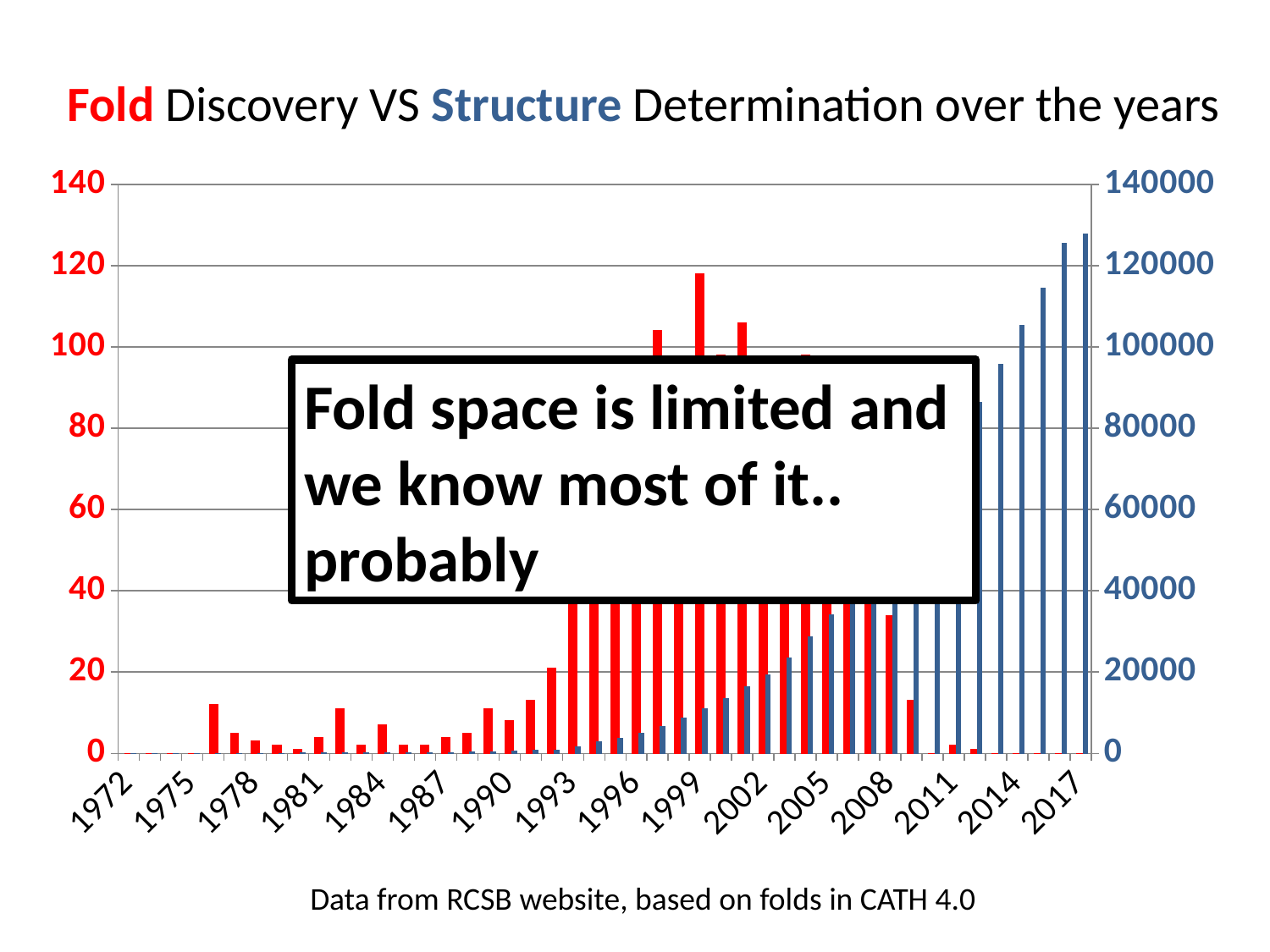
Is the red Fold value for 1991 greater or less than 20? less In which year is the blue Structure bar highest? 2017 What kind of chart is shown on the slide? bar chart Is the blue Structure value for 2014 greater or less than 80000? greater Is the blue Structure value for 2017 greater or less than 120000? greater What is the title of the chart? Fold Discovery VS Structure Determination over the years Do the blue Structure bars generally rise or fall from 1972 to 2017? rise Which year has the larger red Fold bar, 1999 or 2008? 1999 In which year is the red Fold bar highest? 1999 Which colour represents the Structure series in the chart? blue